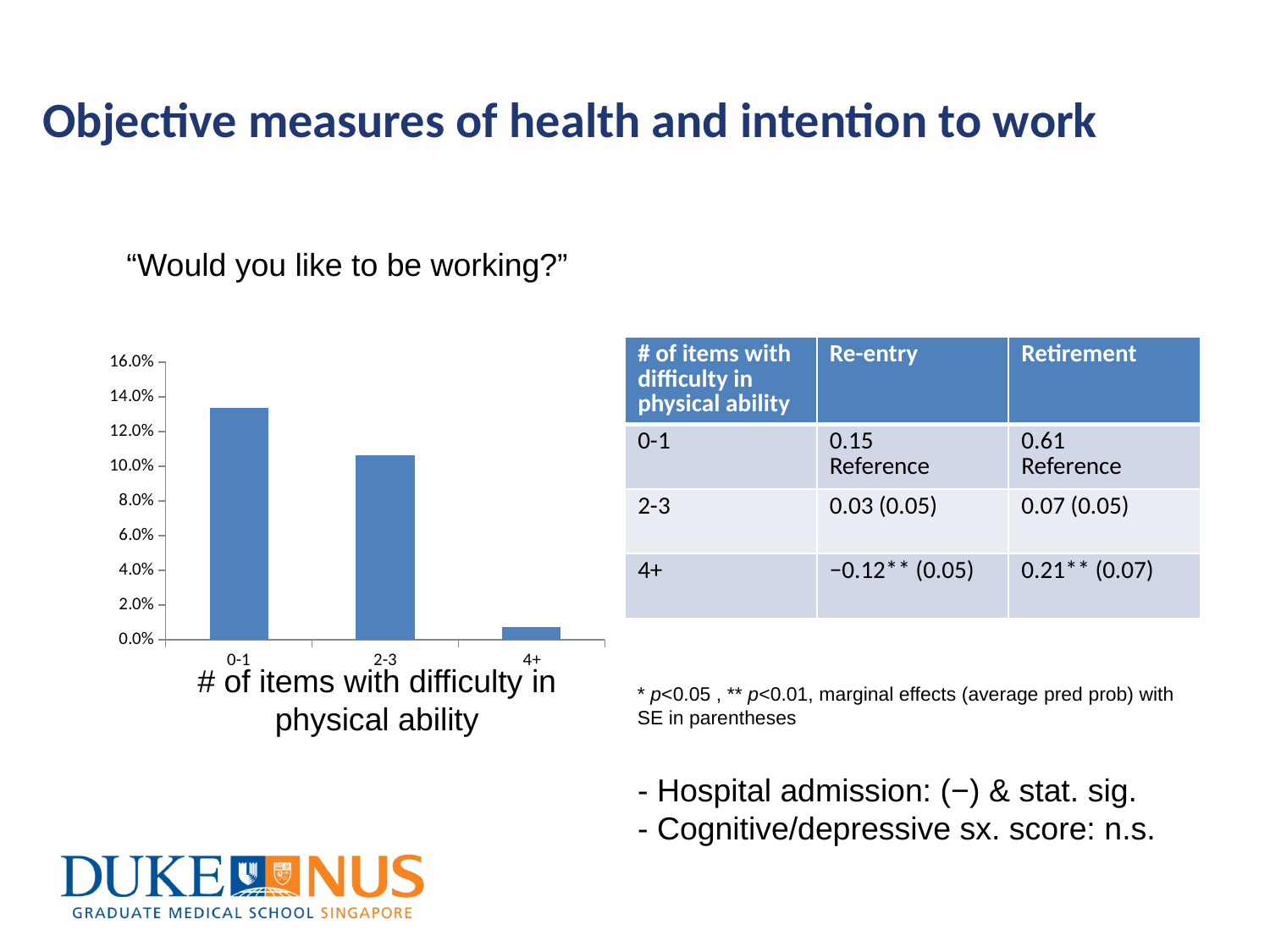
Which is larger, the value for 0-1 or the value for 2-3? 0-1 Is the value for the 4+ category greater or less than 2.0%? less What is the x-axis title of the bar chart? # of items with difficulty in physical ability What is the maximum value shown on the y axis of the chart? 16.0% Which category has the lowest bar in the chart? 4+ Which is larger, the value for 2-3 or the value for 4+? 2-3 Which category has the highest bar in the chart? 0-1 Is the value for the 2-3 category greater or less than 8.0%? greater What kind of chart is shown on the slide? bar chart How many categories are shown on the x axis of the bar chart? 3 Do the bar values rise or fall as the number of items with difficulty in physical ability increases along the x axis? fall Is the value for the 0-1 category greater or less than 12.0%? greater